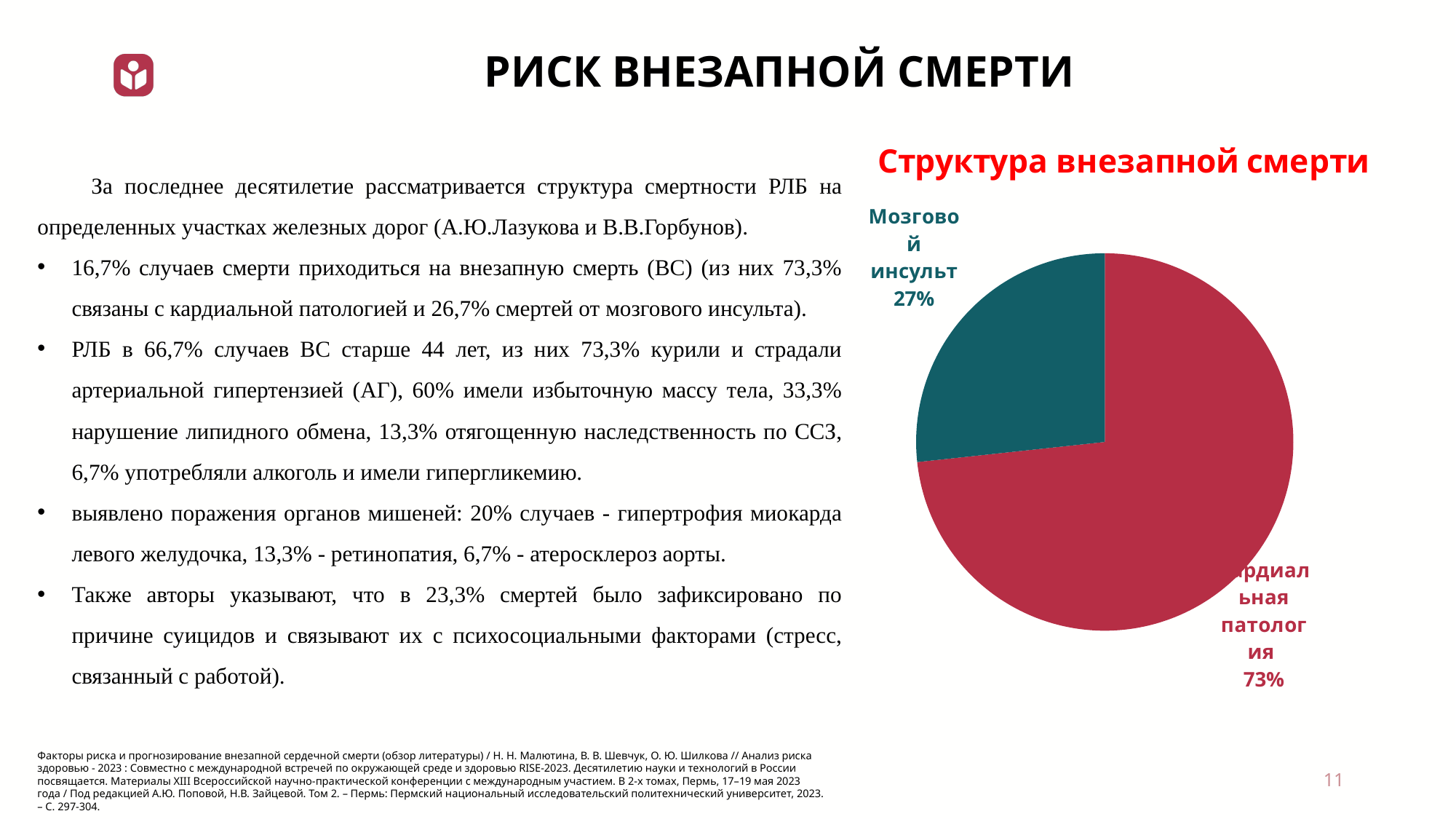
In the pie chart "Структура внезапной смерти", what is the difference in percentage points between "Кардиальная патология" and "Мозговой инсульт"? 46 In the pie chart "Структура внезапной смерти", which is larger: "Мозговой инсульт" or "Кардиальная патология"? Кардиальная патология In the pie chart "Структура внезапной смерти", which slice is the largest? Кардиальная патология What type of chart is shown under the title "Структура внезапной смерти"? pie chart In the pie chart "Структура внезапной смерти", how many slices are there? 2 In the pie chart "Структура внезапной смерти", what colour is the "Мозговой инсульт" slice? dark teal In the pie chart "Структура внезапной смерти", what share of the pie does "Мозговой инсульт" take? 27% In the pie chart "Структура внезапной смерти", which slice is the smallest? Мозговой инсульт What is the title of the chart on the right side of the slide? Структура внезапной смерти In the pie chart "Структура внезапной смерти", what share is labelled for "Кардиальная патология"? 73% In the pie chart "Структура внезапной смерти", what share is labelled for "Мозговой инсульт"? 27%